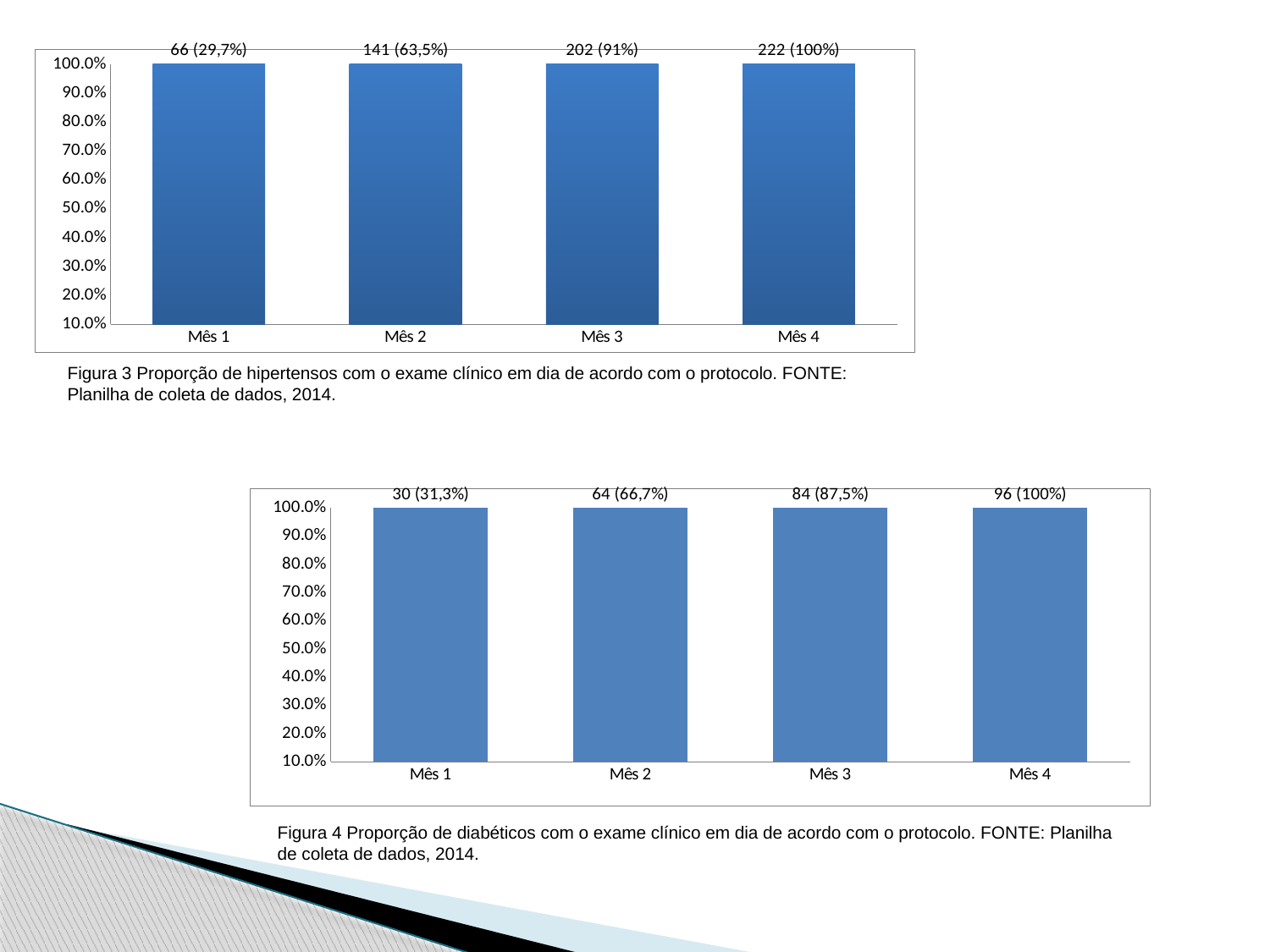
In the bottom chart (Figura 4), which month has the lowest count in its data label? Mês 1 In the bottom chart (Figura 4), what is the data label shown for Mês 4? 96 (100%) How many months (categories) are shown on the x axis of the top chart (Figura 3)? 4 In the bottom chart (Figura 4), which has the larger labelled count, Mês 2 or Mês 3? Mês 3 In the top chart (Figura 3), what is the difference between the counts labelled for Mês 4 and Mês 1? 156 According to the caption, what does the top chart (Figura 3) show? Proporção de hipertensos com o exame clínico em dia de acordo com o protocolo In the top chart (Figura 3), what is the data label shown for Mês 3? 202 (91%) In the bottom chart (Figura 4), what is the difference between the counts labelled for Mês 3 and Mês 2? 20 What kind of chart is the bottom chart (Figura 4)? Bar chart In the top chart (Figura 3), which month has the highest count in its data label? Mês 4 In the top chart (Figura 3), what is the data label shown for Mês 1? 66 (29,7%) In the bottom chart (Figura 4), what is the data label shown for Mês 2? 64 (66,7%)